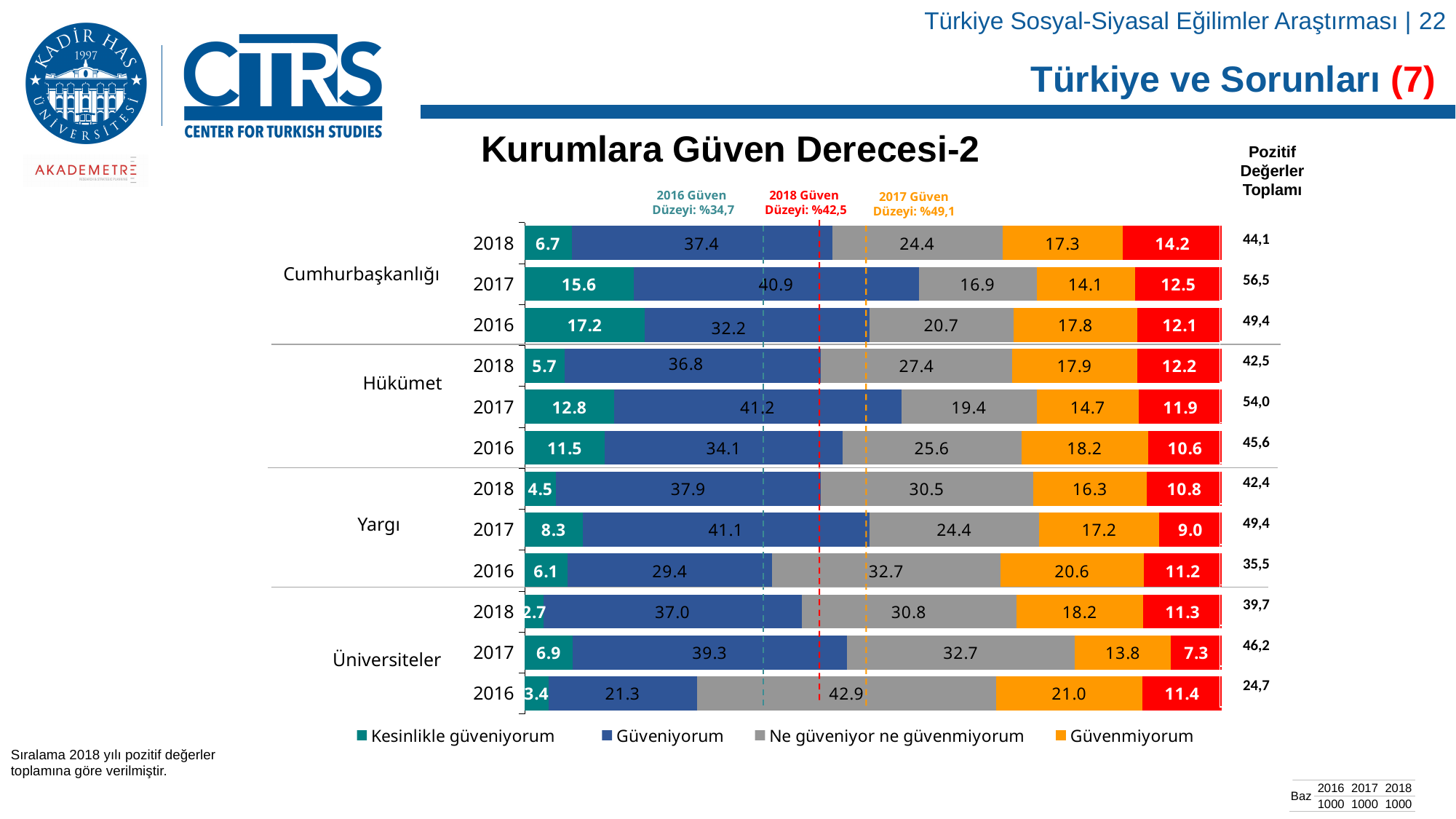
How much higher is the Güveniyorum value for Cumhurbaşkanlığı in 2017 than in 2018? 3.5 What is the Pozitif Değerler Toplamı for Hükümet in 2017? 54,0 What is the Güvenmiyorum value for Yargı in 2016? 20.6 For Hükümet, which year has the larger Kesinlikle güveniyorum value, 2017 or 2016? 2017 Does the Kesinlikle güveniyorum value for Cumhurbaşkanlığı rise or fall from 2016 to 2018? Fall What is the Ne güveniyor ne güvenmiyorum value for Üniversiteler in 2016? 42.9 Which institution and year has the lowest Pozitif Değerler Toplamı? Üniversiteler 2016 In the Kurumlara Güven Derecesi-2 chart, what is the Kesinlikle güveniyorum value for Cumhurbaşkanlığı in 2017? 15.6 What kind of chart is shown on the slide? Stacked bar chart What is the 2018 Güven Düzeyi shown above the chart? %42,5 Which institution and year has the highest Pozitif Değerler Toplamı? Cumhurbaşkanlığı 2017 How many series does the legend list? 4